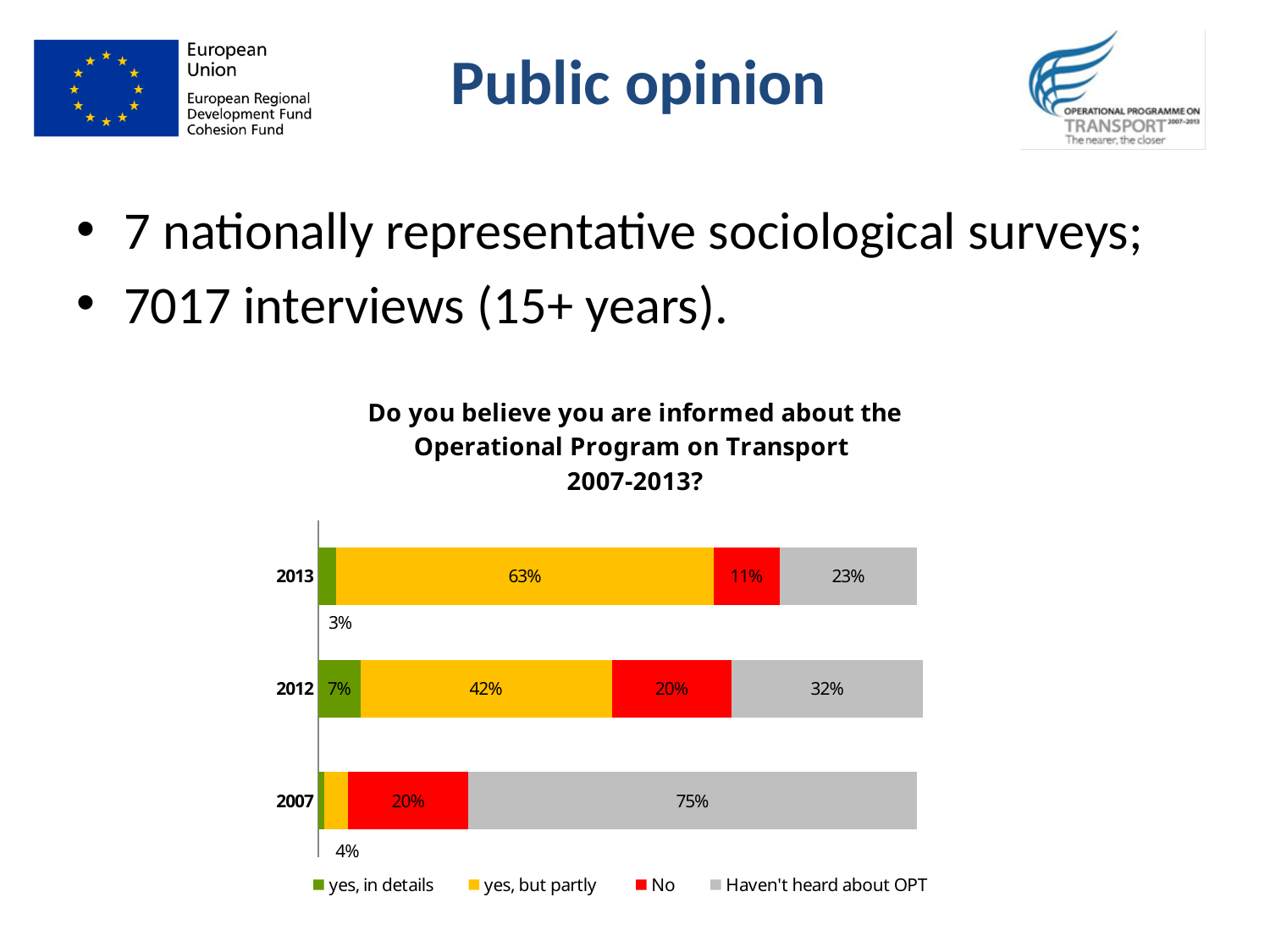
In which year was the share of respondents who hadn't heard about OPT the highest? 2007 What percentage of respondents in 2012 answered "yes, in details"? 7% What percentage of respondents in 2013 answered "yes, but partly"? 63% In which year was the share of respondents answering "No" the lowest? 2013 What percentage of respondents in 2012 answered "No"? 20% What type of chart is shown on the slide? Stacked bar chart How many years are shown in the chart? 3 By how many percentage points did the "yes, but partly" share in 2013 exceed that in 2012? 21 percentage points Does the share of respondents who hadn't heard about OPT rise or fall from 2007 to 2013? Fall Which year had a larger share of respondents who hadn't heard about OPT, 2012 or 2013? 2012 What percentage of respondents in 2007 answered "Haven't heard about OPT"? 75% How many answer categories does the legend list? 4